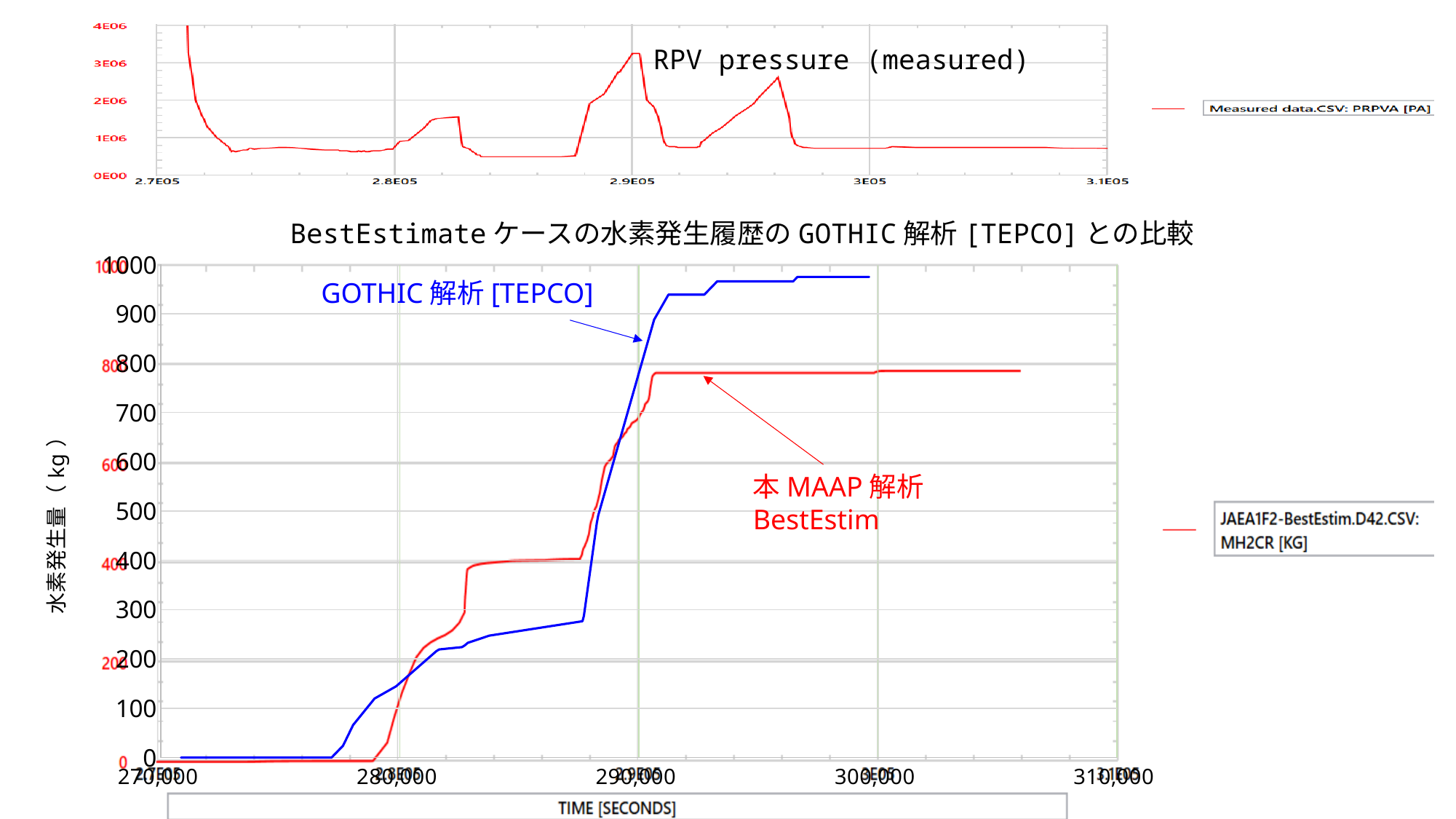
In the bottom hydrogen generation chart, which line is higher at time 300,000 seconds, GOTHIC 解析 [TEPCO] or 本 MAAP 解析 BestEstim? GOTHIC 解析 [TEPCO] In the top 'RPV pressure (measured)' chart, is the peak pressure near 2.9E05 seconds greater or less than 3E06? greater What kind of chart is the top chart titled 'RPV pressure (measured)'? line chart In the bottom hydrogen generation chart, how many lines are plotted? 2 In the bottom hydrogen generation chart, is the final plateau of the 本 MAAP 解析 BestEstim line greater or less than 700 kg? greater In the bottom hydrogen generation chart, is the GOTHIC 解析 [TEPCO] value at 285,000 seconds greater or less than 300 kg? less In the bottom hydrogen generation chart, which line is higher at time 285,000 seconds, GOTHIC 解析 [TEPCO] or 本 MAAP 解析 BestEstim? 本 MAAP 解析 BestEstim What is the x-axis label of the bottom hydrogen generation chart? TIME [SECONDS] In the bottom hydrogen generation chart, do the plotted values generally rise or fall as time increases? rise What kind of chart is the bottom chart comparing hydrogen generation histories? line chart